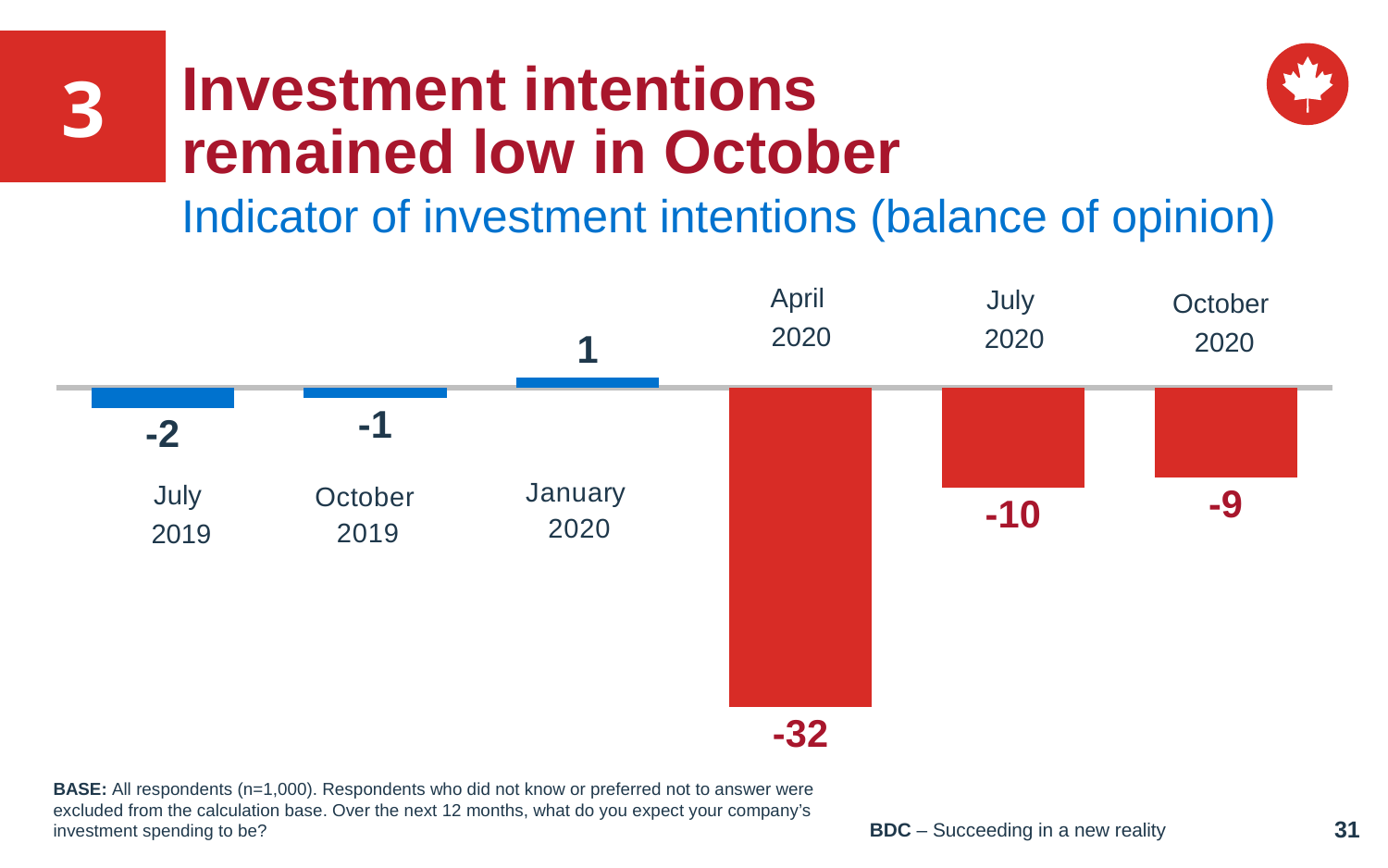
Which period has the lowest value? April 2020 Which is larger, the value for October 2019 or the value for July 2019? October 2019 What is the difference between the values for July 2020 and October 2020? 1 What is the difference between the values for April 2020 and July 2020? 22 Which period has the highest value? January 2020 What is the value for October 2020? -9 What is the value for January 2020? 1 What is the title of the chart? Indicator of investment intentions (balance of opinion) How many periods are shown in the chart? 6 What is the value for July 2019? -2 What kind of chart is this? Bar chart What is the value for April 2020? -32